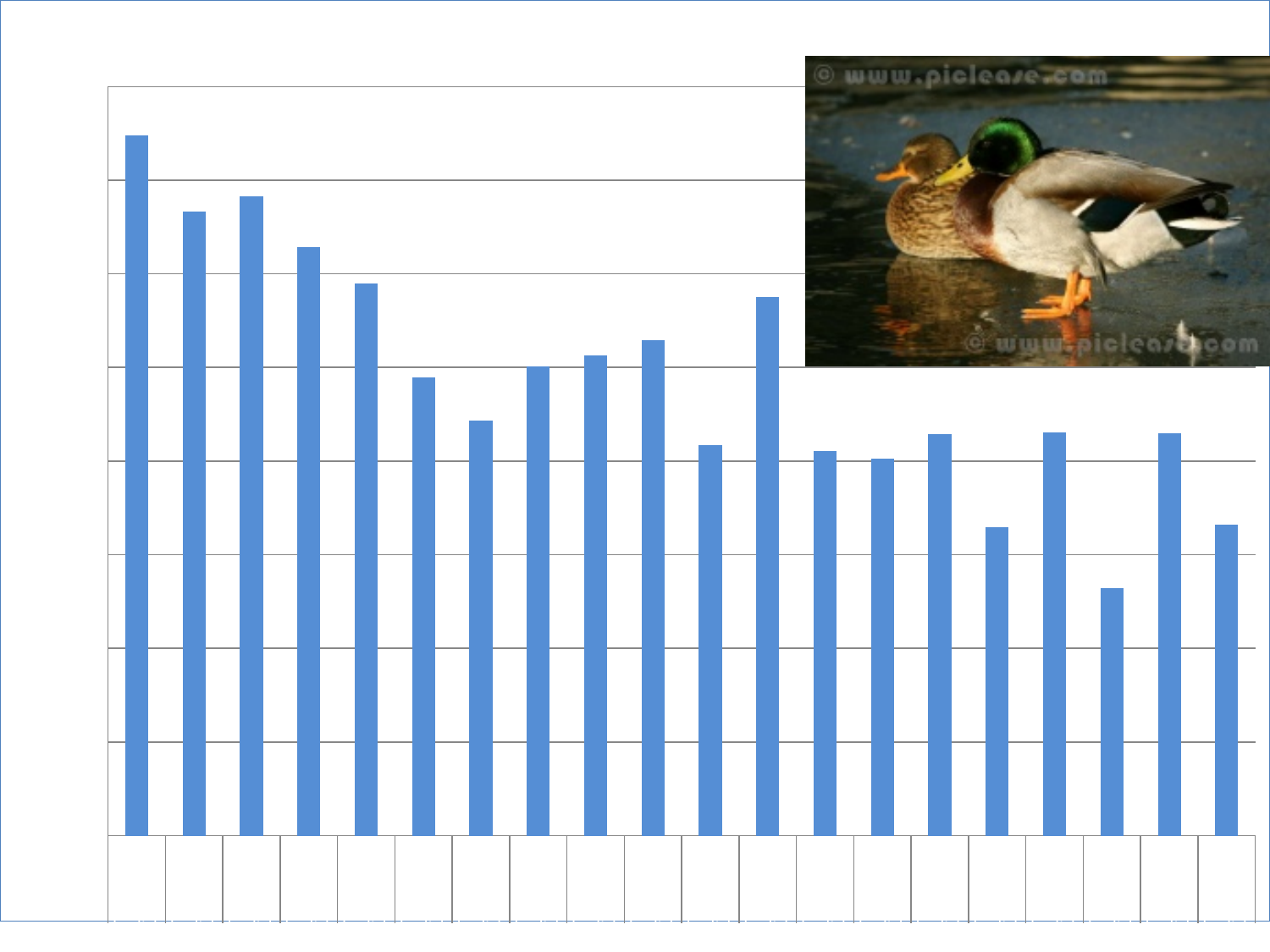
How many bars does the chart contain? 20 What animal is shown in the photograph placed over the top right of the chart? ducks Which is taller, the first bar from the left or the last bar on the right? the first bar from the left Which is taller, the eleventh bar from the left or the twelfth bar from the left? the twelfth bar from the left Which bar is the shortest in the chart? the third bar from the right Do the bar values generally rise or fall from left to right across the chart? fall Which bar is the tallest in the chart? the first bar from the left What colour are the bars in the chart? blue What kind of chart is shown on the slide? bar chart Which is taller, the fifth bar from the left or the sixth bar from the left? the fifth bar from the left